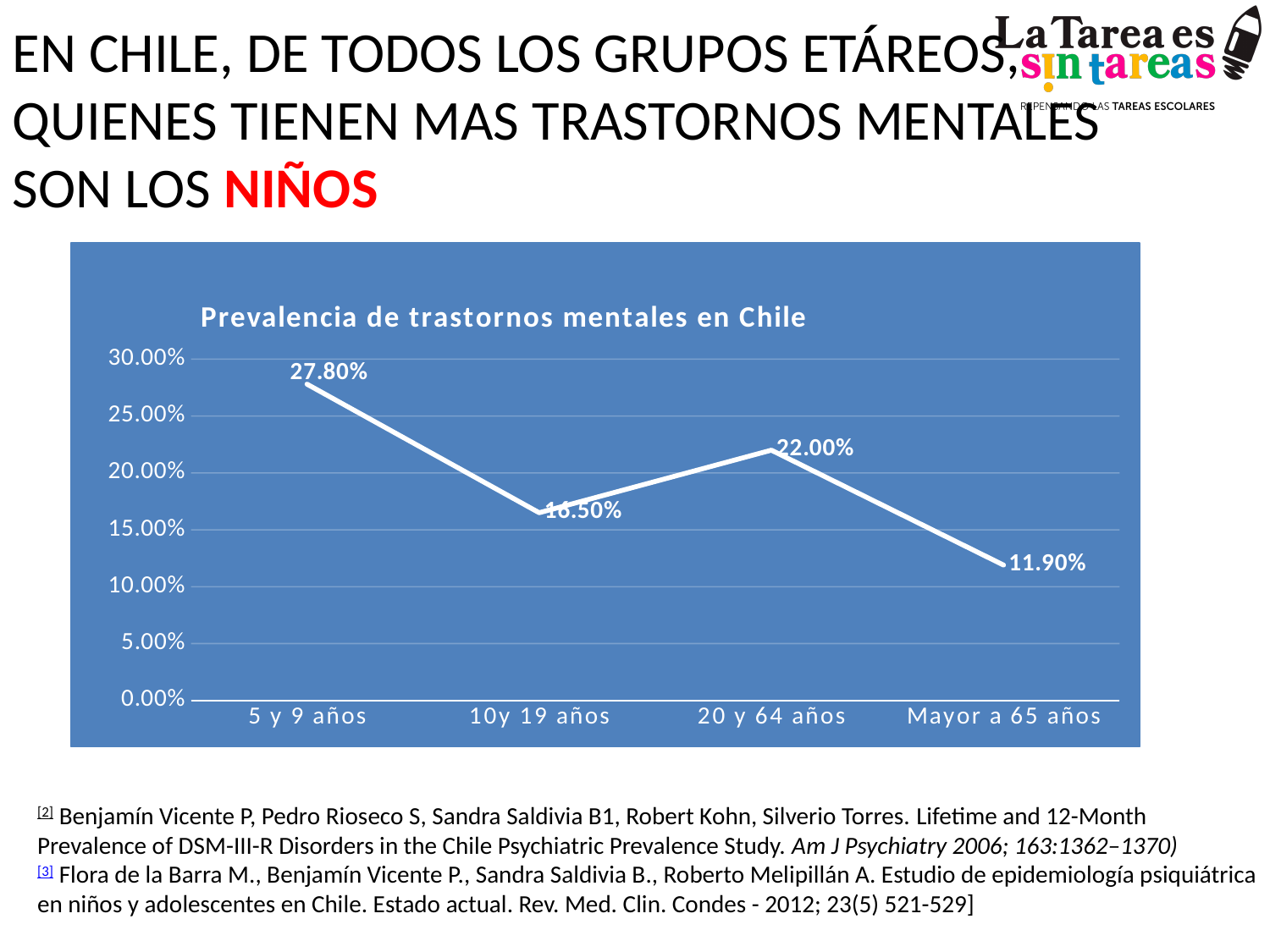
What is the value for the "Mayor a 65 años" group? 11.90% What is the value for the "20 y 64 años" group? 22.00% Which age group has the highest prevalence? 5 y 9 años What is the difference between the values for "20 y 64 años" and "10y 19 años"? 5.50% What kind of chart is shown on the slide? Line chart Which age group has the lowest prevalence? Mayor a 65 años What is the title of the chart? Prevalencia de trastornos mentales en Chile How many age groups are plotted on the chart? 4 What is the value for the "10y 19 años" group? 16.50% What is the difference between the values for "5 y 9 años" and "Mayor a 65 años"? 15.90% What is the value for the "5 y 9 años" group? 27.80% Which is larger, the value for "20 y 64 años" or the value for "10y 19 años"? 20 y 64 años